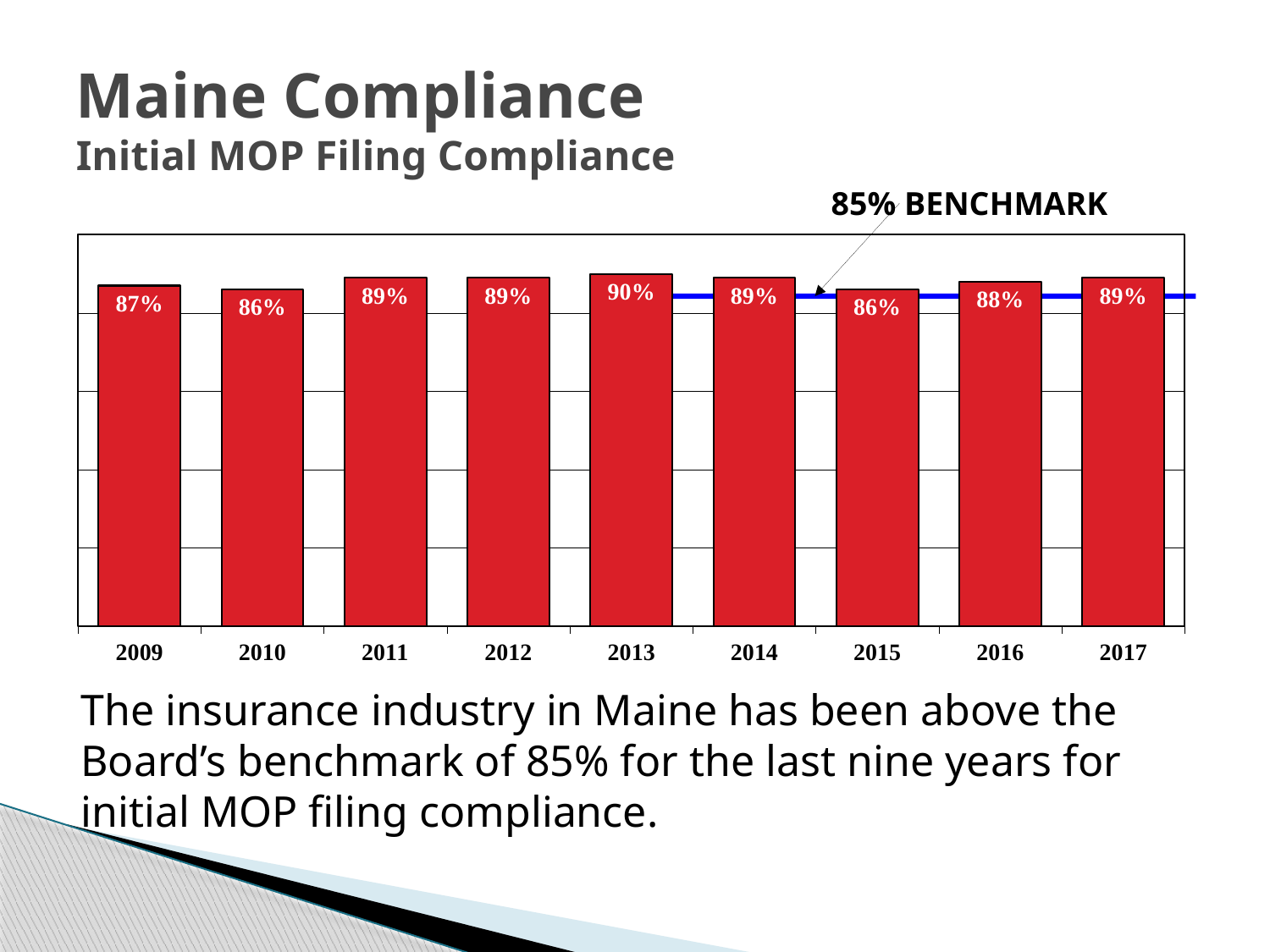
Which year has the highest compliance value? 2013 What kind of chart is shown on the slide? Bar chart What is the compliance value shown for 2017? 89% Which years have the lowest compliance value? 2010 and 2015 Which is larger, the compliance value for 2011 or for 2015? 2011 What is the difference between the compliance values for 2013 and 2010? 4 percentage points What is the compliance value shown for 2016? 88% How many years are shown on the x axis of the chart? 9 What colour are the bars in the chart? Red What benchmark value does the horizontal blue line represent? 85% What is the initial MOP filing compliance value for 2009? 87% What is the compliance value shown for 2013? 90%